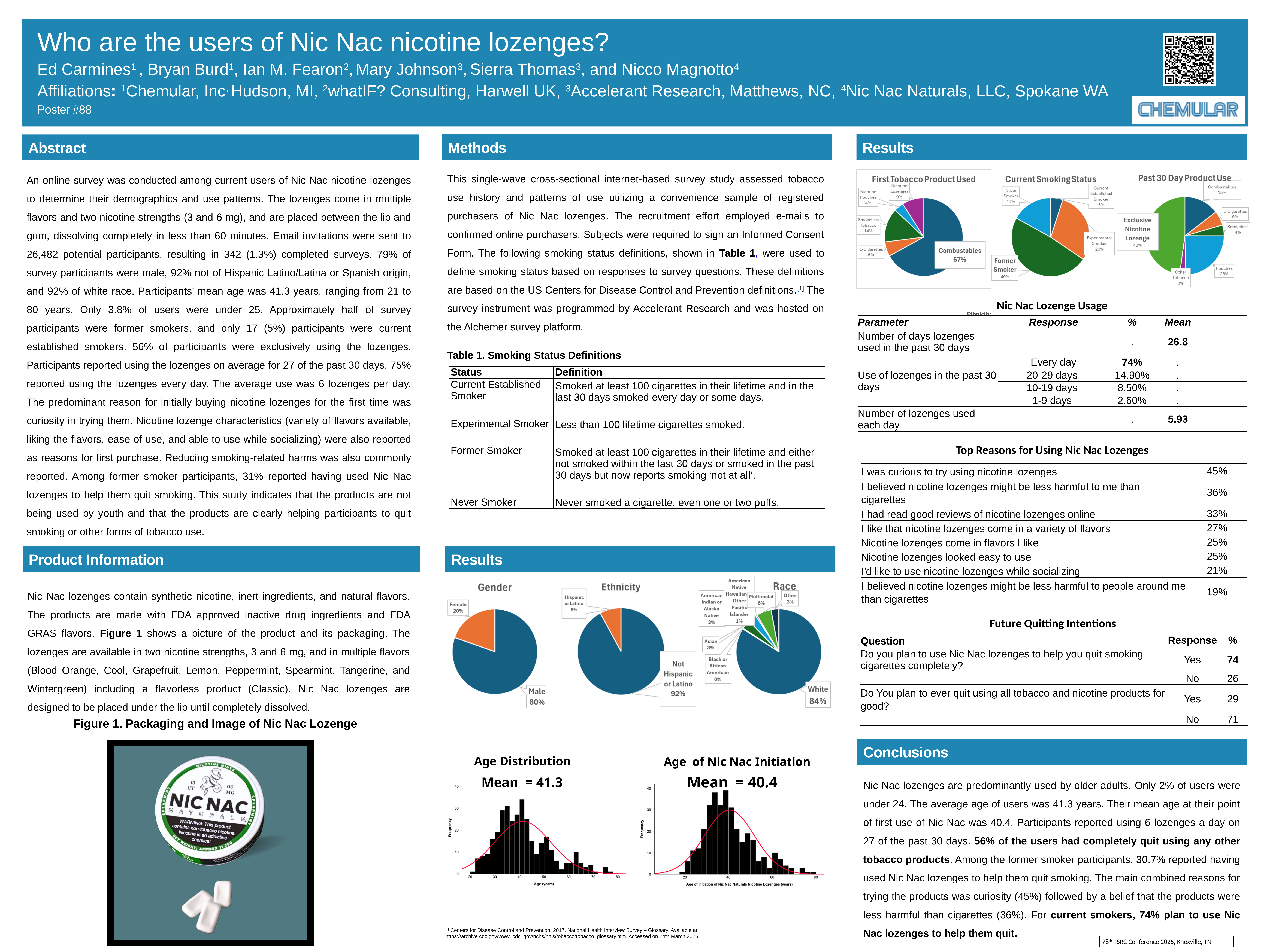
In the Ethnicity pie chart, what share of participants are Hispanic or Latino? 8% In the Race pie chart, which category has the largest slice? White In the Current Smoking Status pie chart, what is the difference between the Former Smoker and Experimental Smoker percentages? 20% What is the mean shown on the Age Distribution chart? 41.3 In the First Tobacco Product Used pie chart, which category has the smallest slice? Nicotine Pouches In the Past 30 Day Product Use pie chart, what percentage is shown for Exclusive Nicotine Lozenge? 48% In the Past 30 Day Product Use pie chart, which is larger, Pouches or Combustables? Pouches In the Current Smoking Status pie chart, what percentage of participants are Former Smokers? 49% In the Race pie chart, what percentage is shown for Multiracial? 6% What type of chart is the Age of Nic Nac Initiation chart? Histogram (bar chart) In the Gender pie chart, what percentage of participants are Male? 80% In the First Tobacco Product Used pie chart, what percentage is shown for Combustables? 67%